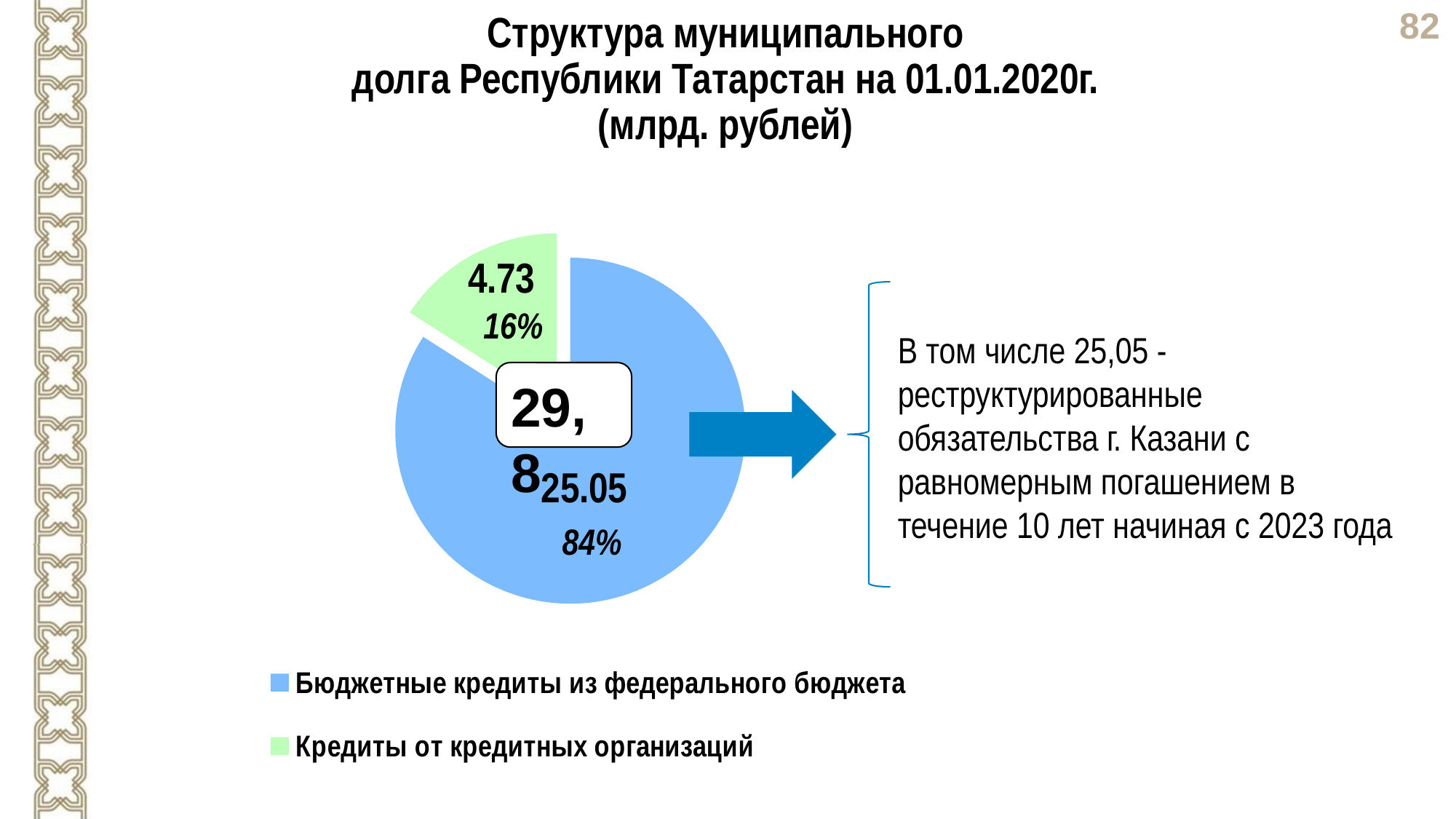
What share of the pie does Бюджетные кредиты из федерального бюджета take? 84% What colour is the slice for Кредиты от кредитных организаций? Green What is the value for Кредиты от кредитных организаций? 4.73 What is the difference between the values for Бюджетные кредиты из федерального бюджета and Кредиты от кредитных организаций? 20.32 Which category has the largest slice of the pie? Бюджетные кредиты из федерального бюджета How many slices does the pie chart have? 2 What is the value for Бюджетные кредиты из федерального бюджета? 25.05 What kind of chart is shown on the slide? Pie chart What total value is shown in the centre of the pie chart? 29,8 Which category has the smallest slice of the pie? Кредиты от кредитных организаций Which is larger: Бюджетные кредиты из федерального бюджета or Кредиты от кредитных организаций? Бюджетные кредиты из федерального бюджета What share of the pie does Кредиты от кредитных организаций take? 16%